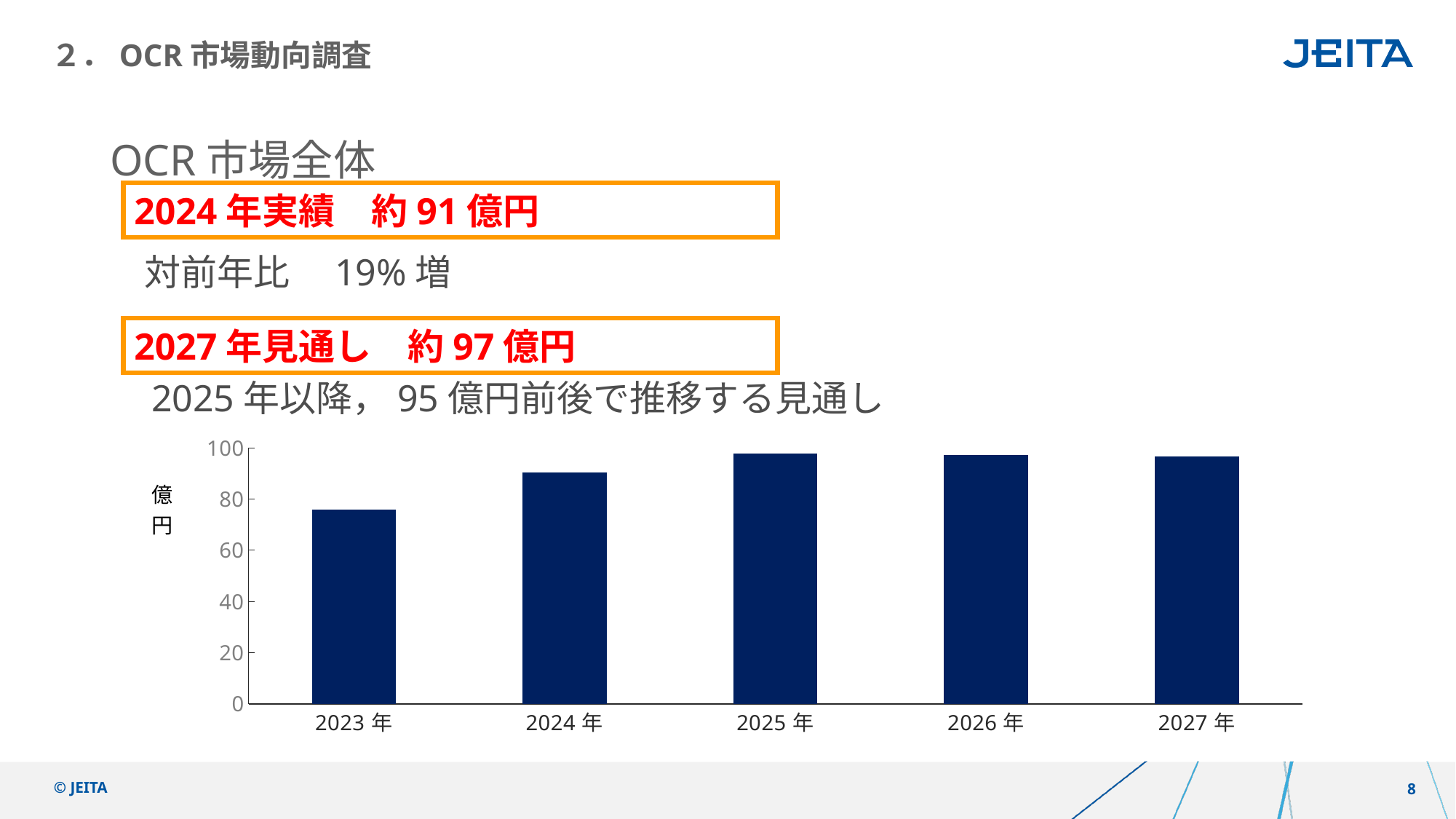
Which year has the lowest bar in the chart? 2023年 Is the value for 2027年 greater or less than 100? less Is the value for 2025年 greater or less than 80? greater Which is larger, the bar for 2023年 or the bar for 2026年? 2026年 Which is larger, the bar for 2023年 or the bar for 2024年? 2024年 What unit is shown on the vertical axis of the chart? 億円 Is the value for 2023年 greater or less than 60? greater How many years (bars) are plotted in the chart? 5 What kind of chart is shown on the slide? bar chart Do the values rise or fall from 2023年 to 2025年? rise